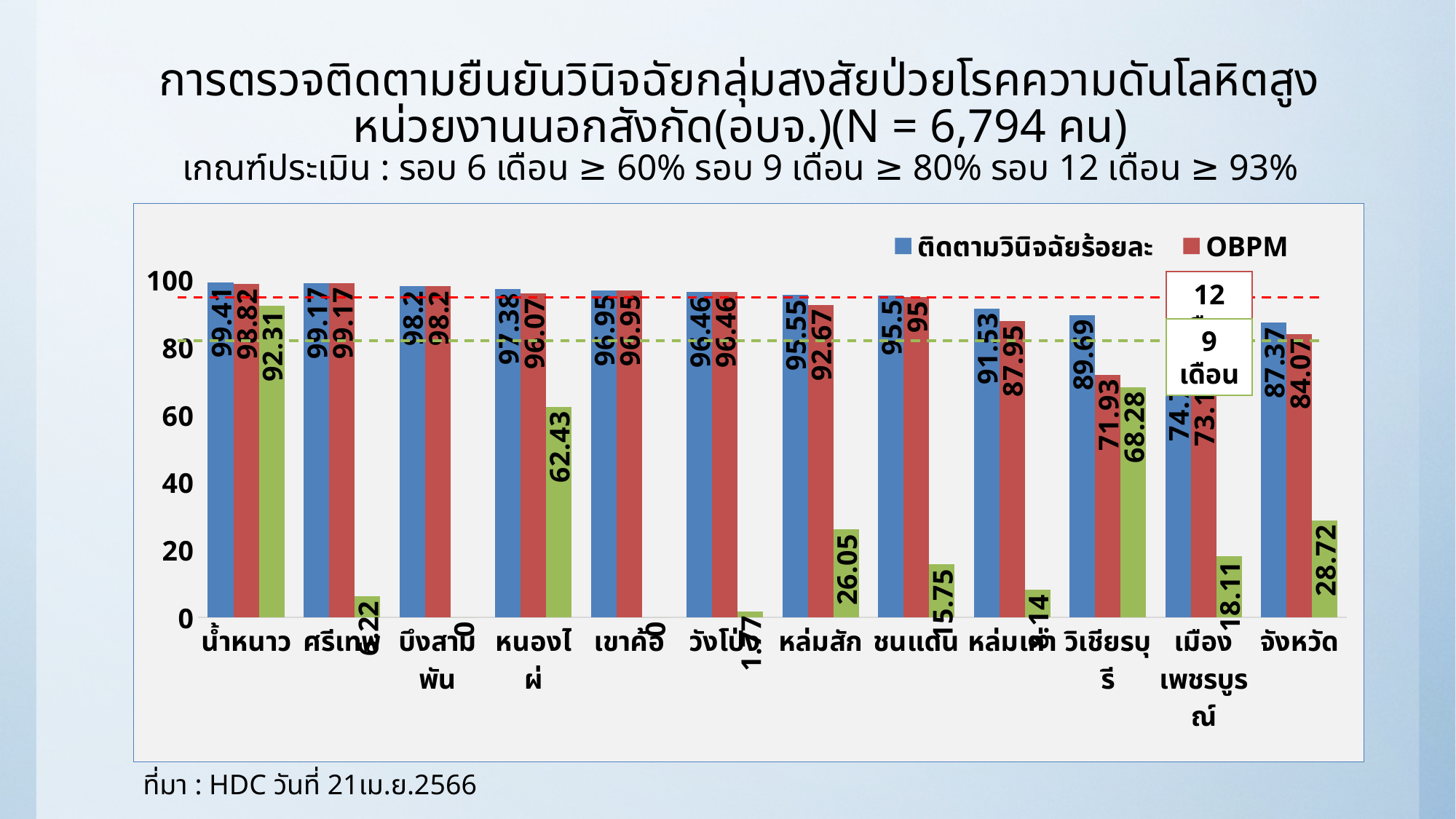
What is the ติดตามวินิจฉัยร้อยละ value for น้ำหนาว? 99.41 Which category has the highest ติดตามวินิจฉัยร้อยละ value? น้ำหนาว What is the OBPM value for หล่มสัก? 92.67 What is the OBPM value for จังหวัด? 84.07 Which has the larger green bar, หนองไผ่ or วิเชียรบุรี? วิเชียรบุรี Is the OBPM value for วิเชียรบุรี greater or less than 80? less What is the difference between the ติดตามวินิจฉัยร้อยละ value and the OBPM value for วิเชียรบุรี? 17.76 What is the value of the green bar for หนองไผ่? 62.43 Which category has the lowest ติดตามวินิจฉัยร้อยละ value? เมืองเพชรบูรณ์ How many categories are shown on the x axis of the chart? 12 What type of chart is shown on the slide? bar chart How many series does the chart's legend list? 2